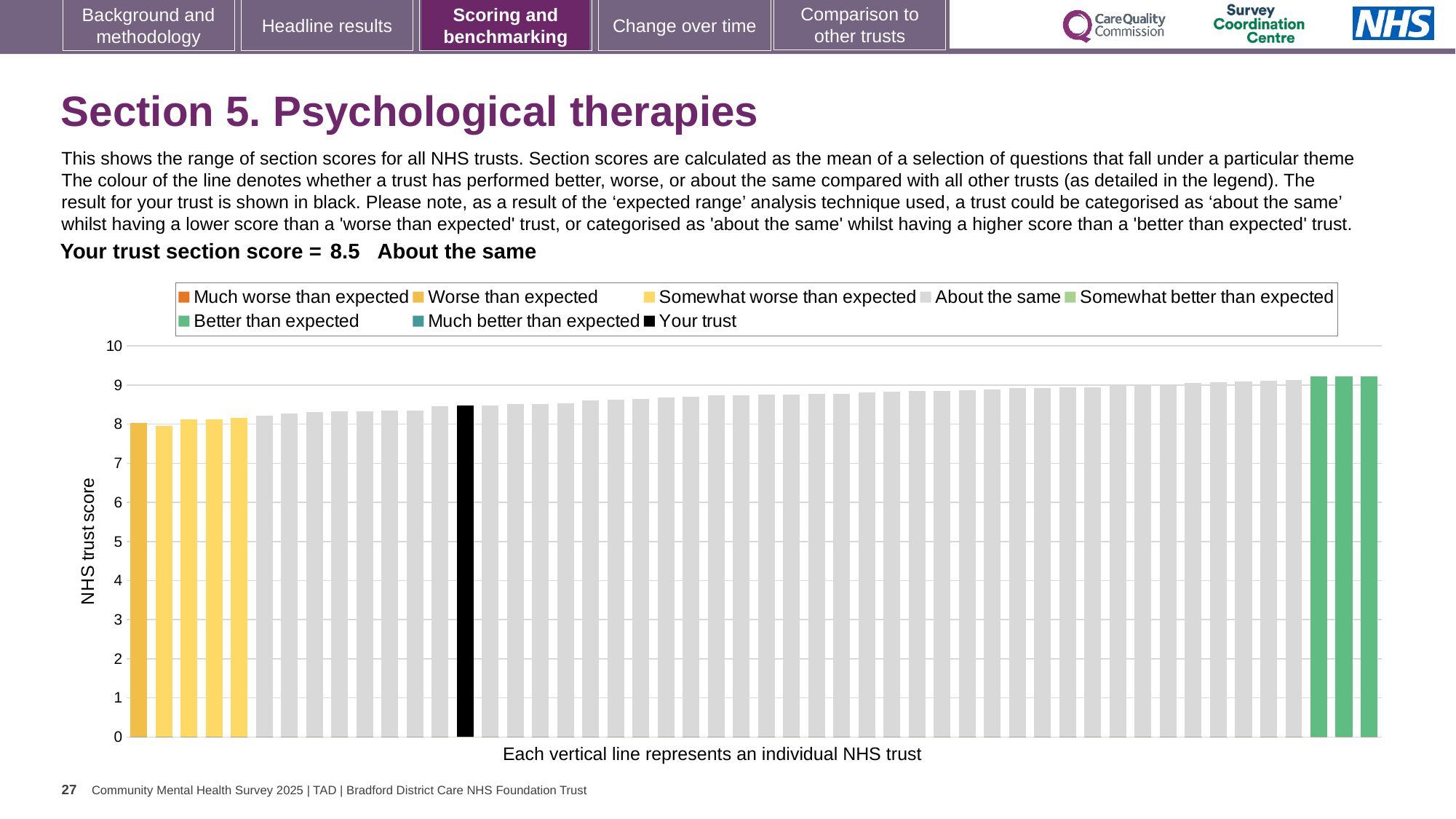
What is the label on the vertical axis of the chart? NHS trust score Do the bar values rise or fall from left to right along the x axis? rise Is the value of the tallest bar greater or less than 10? less What kind of chart is shown on the slide? bar chart How many entries does the chart legend list? 8 What is the section score for your trust shown on the slide? 8.5 What colour is the bar representing your trust? black How many bars are coloured green ('Better than expected')? 3 Are the values of the green 'Better than expected' bars greater or less than 9? greater Is the value of the black 'Your trust' bar greater or less than 8? greater Which is higher, the leftmost bar or the rightmost bar? the rightmost bar